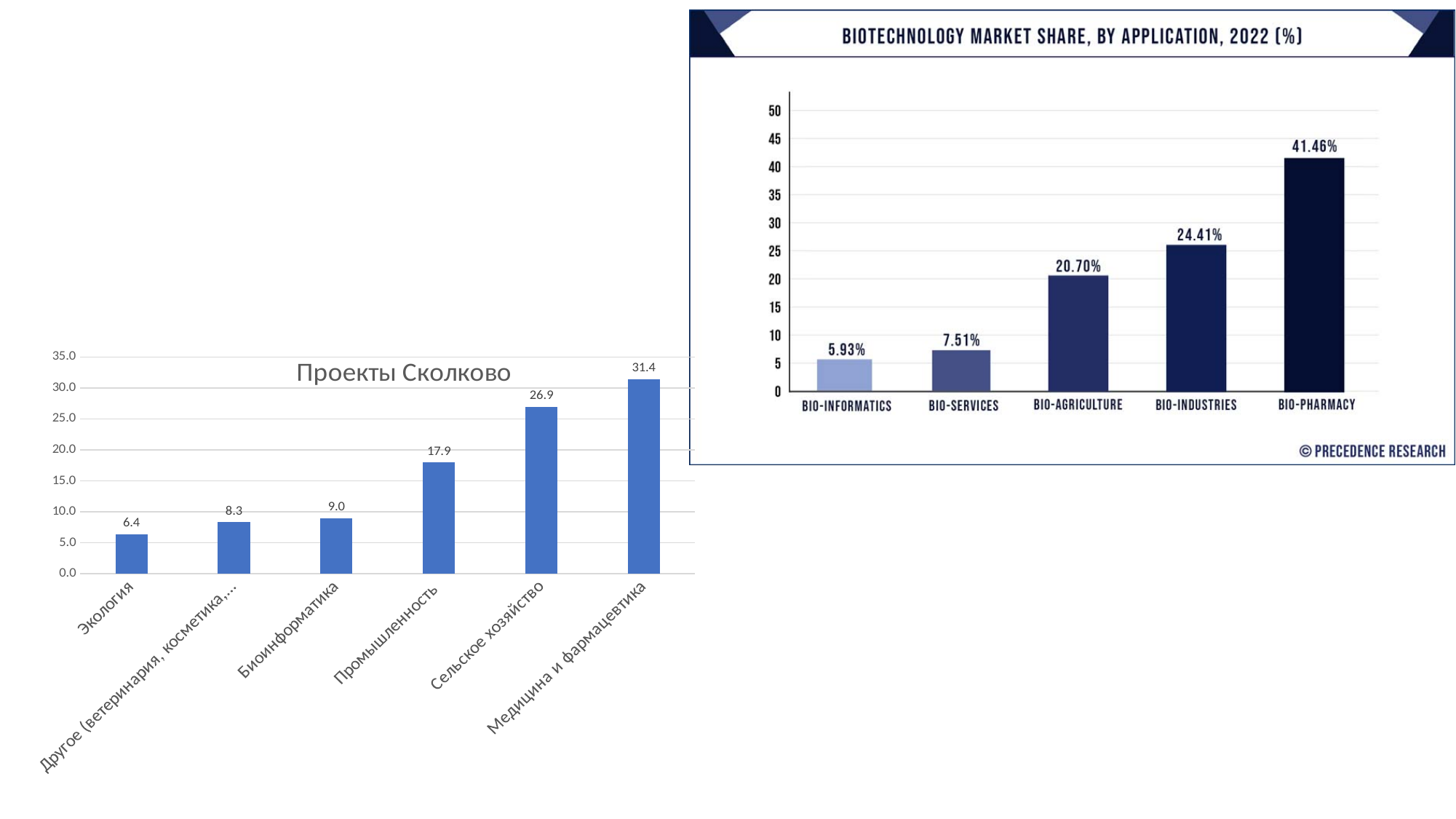
In the 'Проекты Сколково' chart, which category has the lowest value? Экология In the 'Biotechnology Market Share, by Application, 2022 (%)' chart, which application has the largest share? Bio-Pharmacy In the 'Проекты Сколково' chart, how many categories are shown? 6 In the 'Проекты Сколково' chart, what is the value for Промышленность? 17.9 In the 'Проекты Сколково' chart, which category has the highest value? Медицина и фармацевтика In the 'Проекты Сколково' chart, what is the value for Биоинформатика? 9.0 In the 'Проекты Сколково' chart, what is the difference between Медицина и фармацевтика and Сельское хозяйство? 4.5 In the 'Проекты Сколково' chart, do the values rise or fall from left to right? rise In the 'Biotechnology Market Share, by Application, 2022 (%)' chart, what is the value for Bio-Services? 7.51% In the 'Biotechnology Market Share, by Application, 2022 (%)' chart, what is the value for Bio-Agriculture? 20.70% In the 'Biotechnology Market Share, by Application, 2022 (%)' chart, which is larger, Bio-Industries or Bio-Agriculture? Bio-Industries What kind of chart is the 'Biotechnology Market Share, by Application, 2022 (%)' chart? bar chart